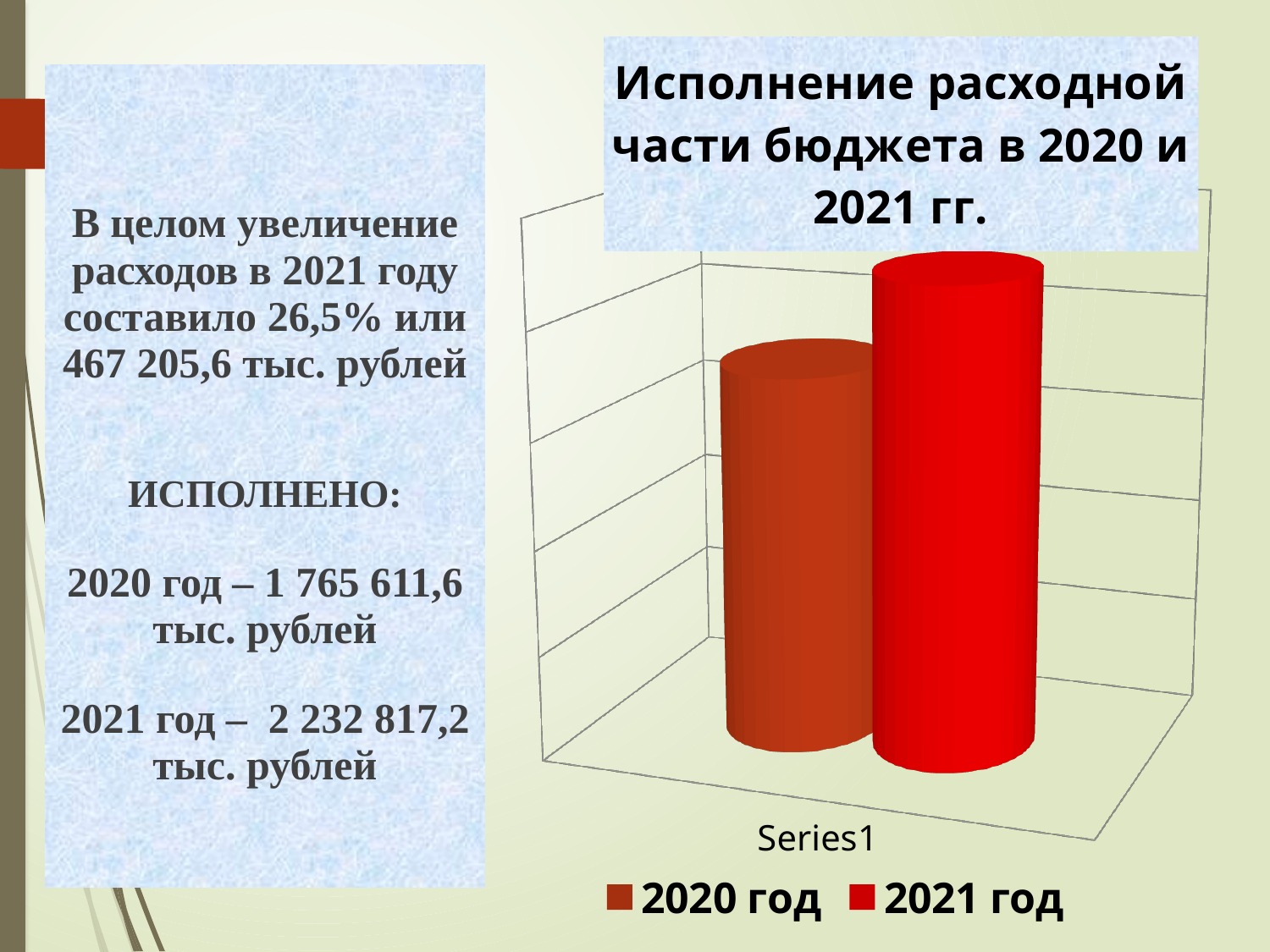
How many categories are shown on the horizontal axis of the chart? 1 What kind of chart is shown on the slide? bar chart Which series has the highest bar in the chart? 2021 год How many series does the chart legend list? 2 Which series has the taller bar, 2020 год or 2021 год? 2021 год Is the bar for 2020 год taller or shorter than the bar for 2021 год? shorter What is the category label shown on the horizontal axis of the chart? Series1 What is the title of the chart? Исполнение расходной части бюджета в 2020 и 2021 гг. Which series has the lowest bar in the chart? 2020 год